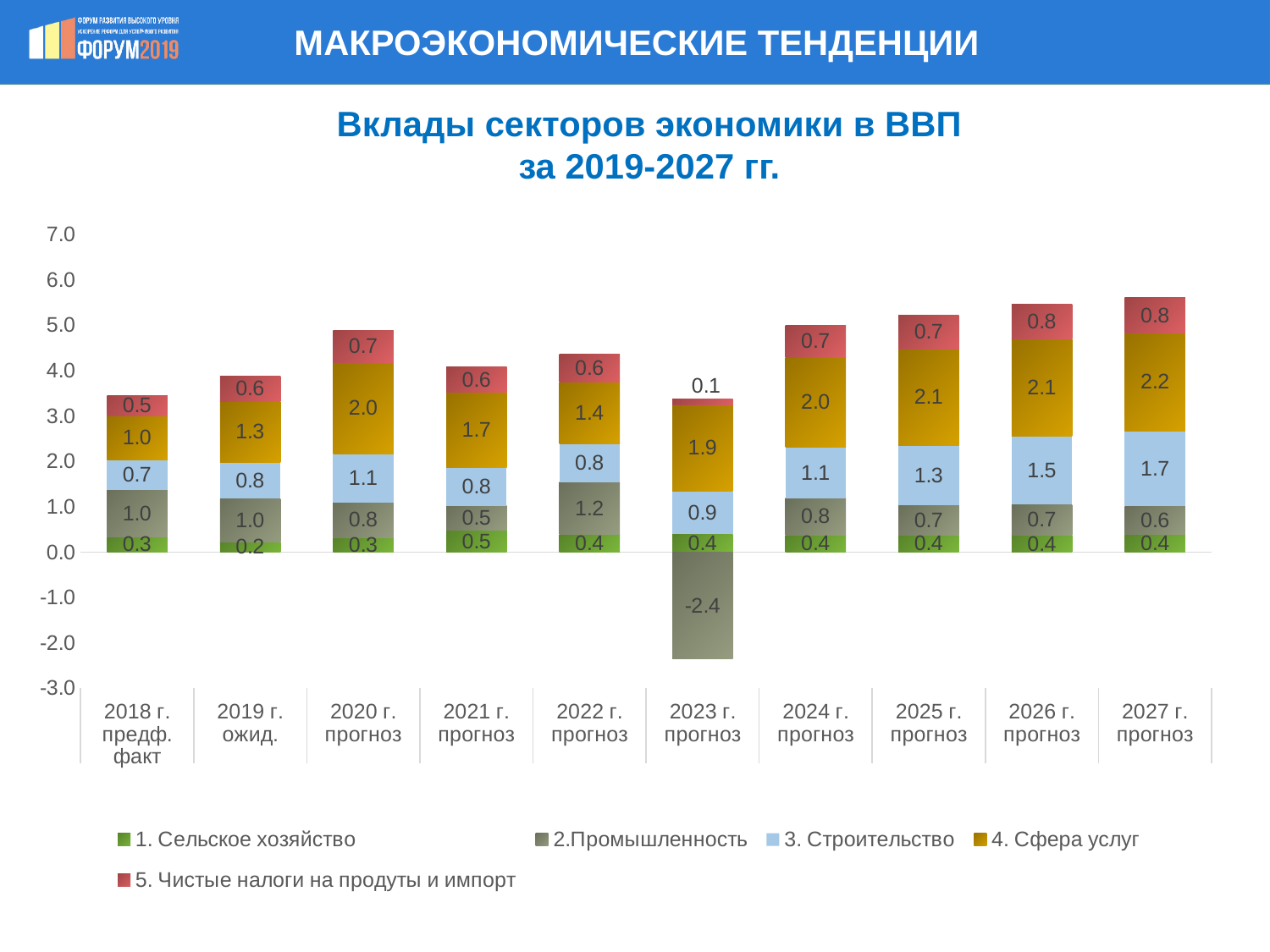
What is the difference between the 4. Сфера услуг values in 2027 г. прогноз and 2018 г. предф. факт? 1.2 How many year categories are shown on the x axis? 10 Which is larger: 3. Строительство in 2025 г. прогноз or 3. Строительство in 2021 г. прогноз? 2025 г. прогноз What is the value for 2.Промышленность in 2023 г. прогноз? -2.4 What is the total of the stacked bar for 2024 г. прогноз? 5.0 In which year is the value for 2.Промышленность the lowest? 2023 г. прогноз What is the value for 3. Строительство in 2026 г. прогноз? 1.5 What kind of chart is shown on the slide? Stacked bar chart In which year does 4. Сфера услуг reach its highest value? 2027 г. прогноз How many series does the legend list? 5 Does the value for 3. Строительство rise or fall from 2023 г. прогноз to 2027 г. прогноз? Rise What is the value for 4. Сфера услуг in 2020 г. прогноз? 2.0